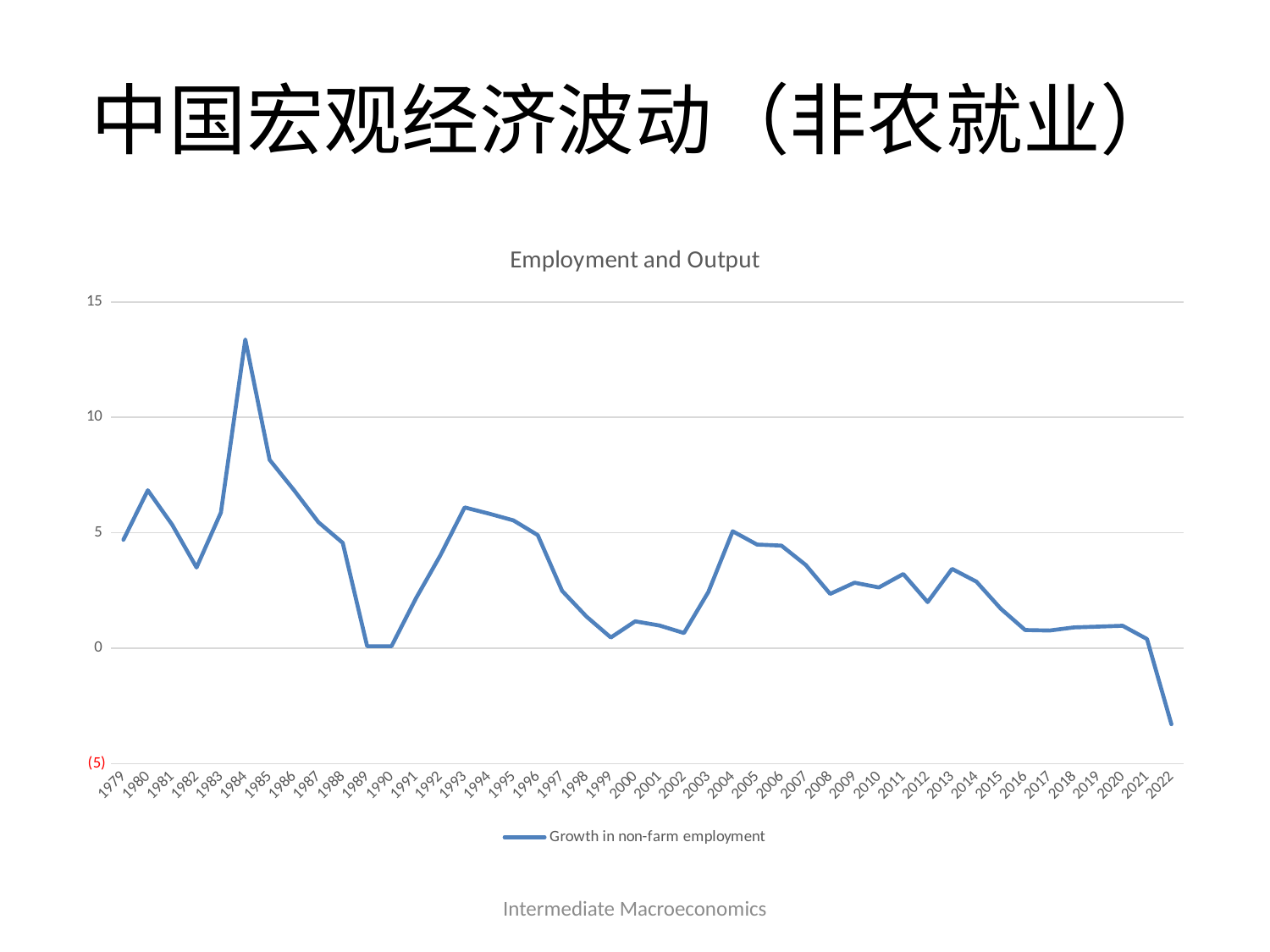
How many series does the legend list? 1 How many years are plotted along the x axis? 44 Is the value for 1984 greater or less than 10? greater In which year is growth in non-farm employment highest? 1984 What kind of chart is shown on the slide? line chart Is the value for 1985 greater or less than 5? greater Is the value for 1999 greater or less than 5? less Which year has the larger value, 1980 or 1982? 1980 Do the values generally rise or fall from 2013 to 2022? fall In which year is growth in non-farm employment lowest? 2022 What is the title of the chart? Employment and Output